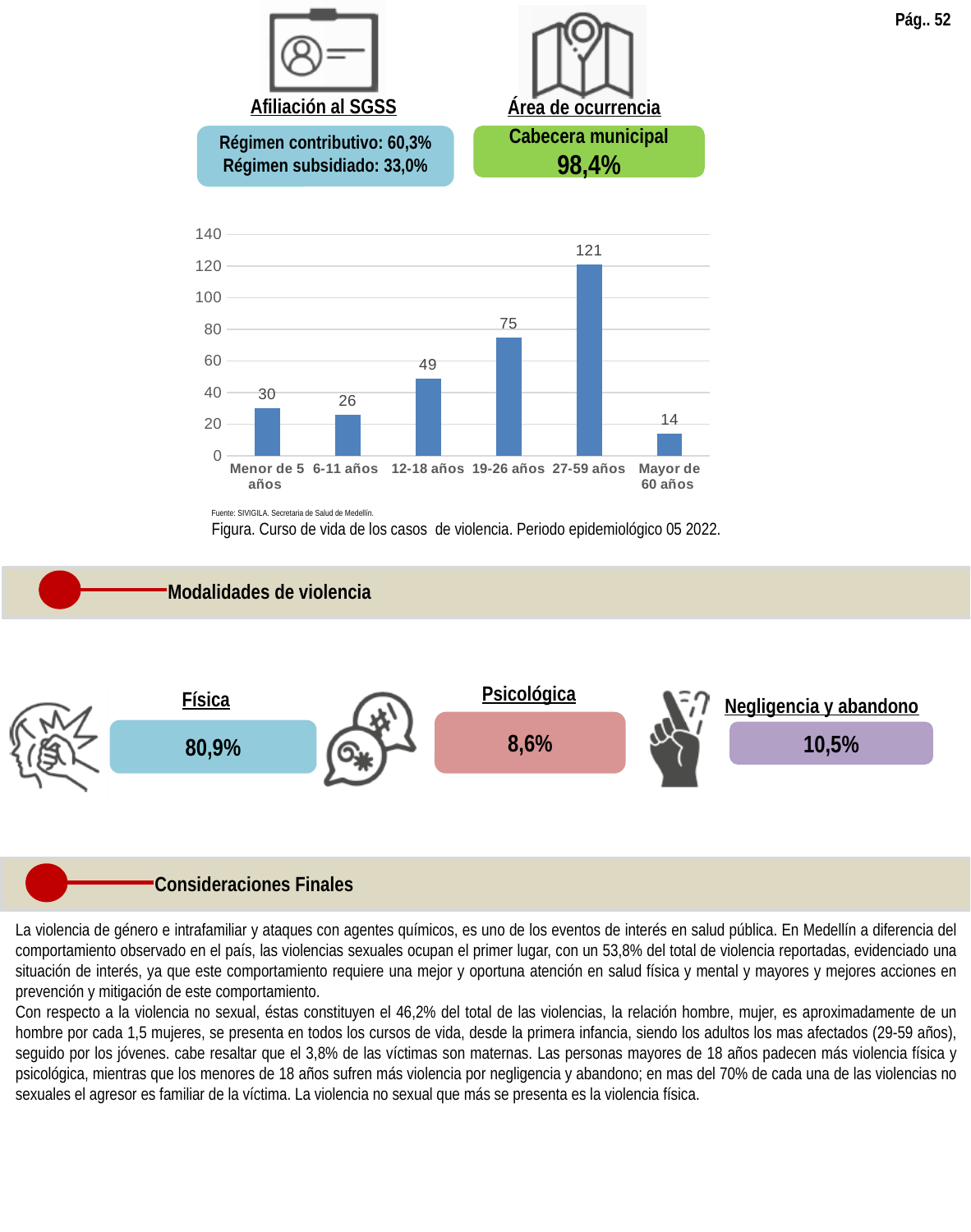
Which age group has the lowest number of cases in the bar chart? Mayor de 60 años Which age group has the highest number of cases in the bar chart? 27-59 años Which is larger in the bar chart, the value for 6-11 años or the value for Menor de 5 años? Menor de 5 años What is the value for the 27-59 años category in the bar chart? 121 What type of chart is used to show the cases of violence by age group? Bar chart What is the highest value shown on the vertical axis of the bar chart? 140 What is the difference between the values for 27-59 años and 19-26 años in the bar chart? 46 Is the value for 19-26 años in the bar chart greater or less than 60? greater How many age categories are shown in the bar chart? 6 What is the value for the 12-18 años category in the bar chart? 49 What is the value for the Menor de 5 años category in the bar chart? 30 What is the caption of the figure below the bar chart? Figura. Curso de vida de los casos de violencia. Periodo epidemiológico 05 2022.